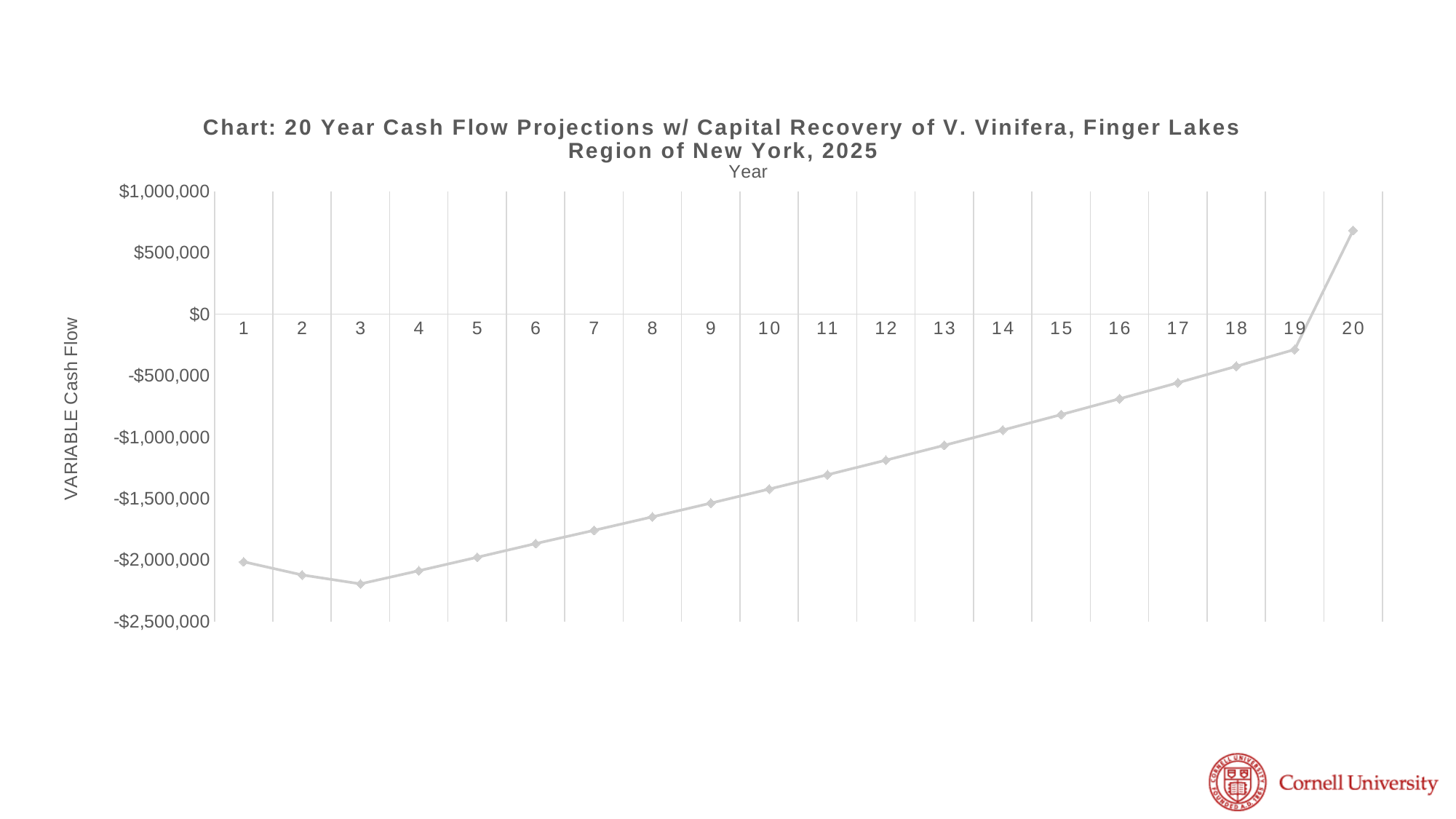
What is the label on the vertical axis of the chart? VARIABLE Cash Flow Is the cash flow value for year 20 greater or less than $500,000? greater Is the cash flow value for year 19 greater or less than -$500,000? greater What kind of chart is shown on the slide? line chart Which year has the highest cash flow value on the chart? 20 Is the cash flow value for year 1 greater or less than -$2,500,000? greater Which year has the larger cash flow value, year 5 or year 15? 15 How many years (data points) are plotted on the chart? 20 Do the cash flow values rise or fall from year 3 to year 20? rise What is the label on the horizontal axis of the chart? Year Which year has the lowest cash flow value on the chart? 3